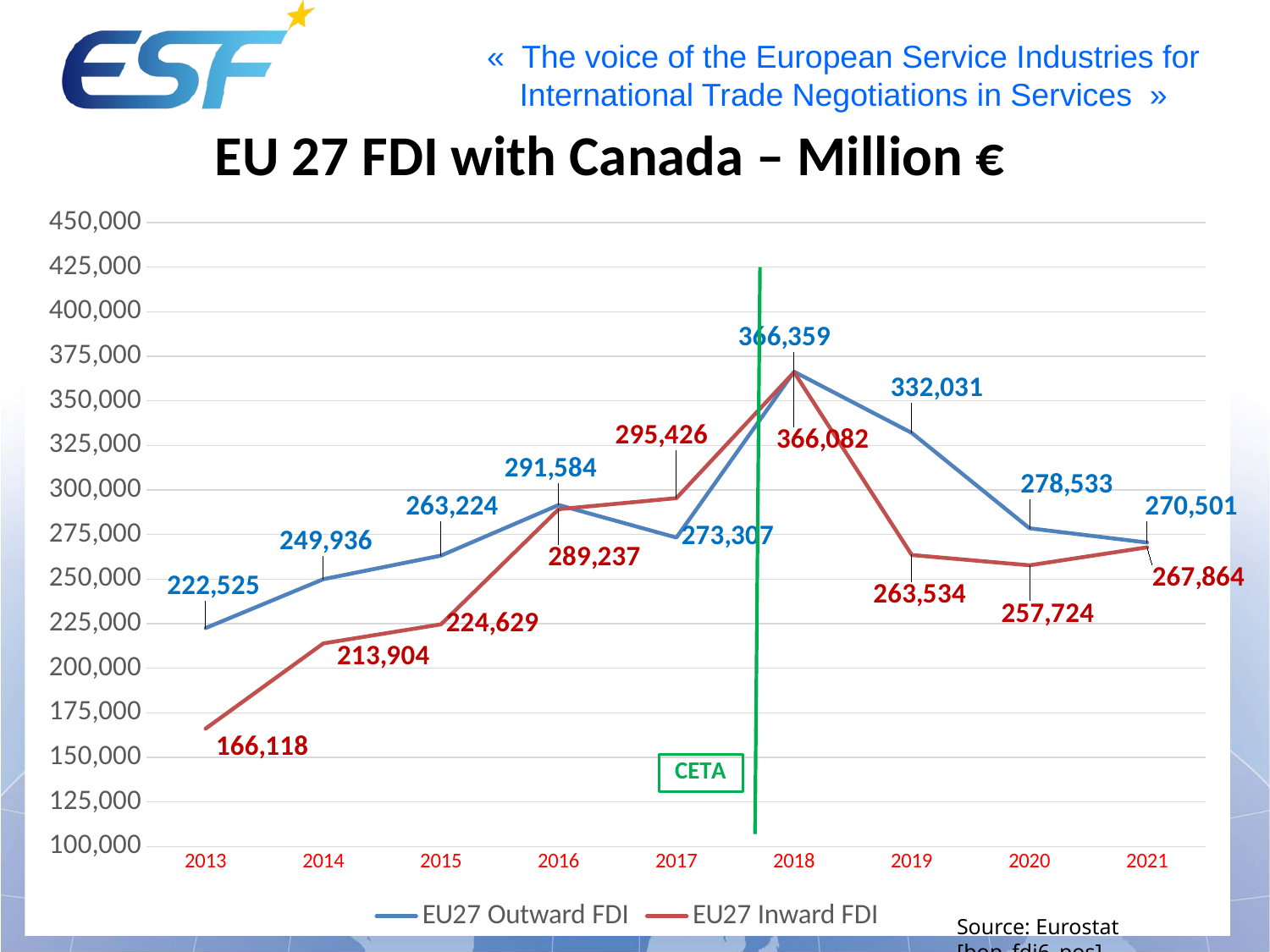
In which year is EU27 Outward FDI highest? 2018 What label is shown next to the green vertical line on the chart? CETA What is the EU27 Outward FDI value for 2013? 222,525 How many years are plotted on the x axis? 9 By how much did EU27 Inward FDI increase from 2013 to 2014? 47,786 In 2017, which is larger: EU27 Outward FDI or EU27 Inward FDI? EU27 Inward FDI In which year is EU27 Inward FDI lowest? 2013 What is the EU27 Inward FDI value for 2019? 263,534 What is the difference between EU27 Outward FDI and EU27 Inward FDI in 2021? 2,637 How many series does the legend list? 2 Does EU27 Outward FDI rise or fall from 2018 to 2021? Fall What kind of chart is shown on the slide? Line chart